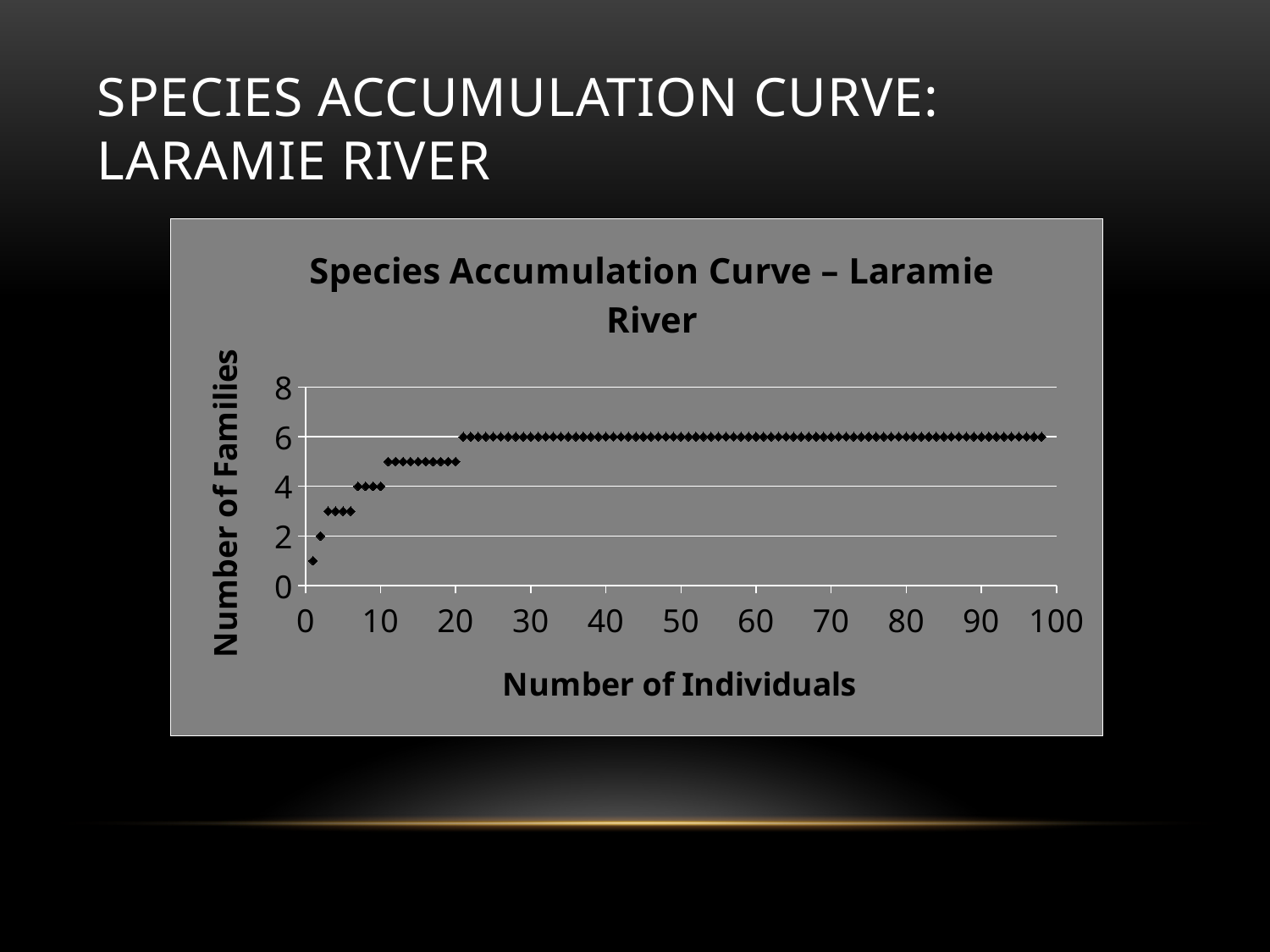
What is the number of families at 50 individuals? 6 What kind of chart is shown on the slide? scatter chart What is the highest number of families reached on the chart? 6 What is the label of the x axis? Number of Individuals How does the number of families change as the number of individuals increases? rises, then levels off at 6 Is the number of families at 5 individuals greater or less than 4? less Which is larger, the number of families at 10 individuals or at 30 individuals? 30 individuals What is the title of the chart? Species Accumulation Curve – Laramie River What is the number of families at 90 individuals? 6 What is the number of families at 10 individuals? 4 Is the number of families at 1 individual greater or less than 2? less Is the number of families at 15 individuals greater or less than 4? greater